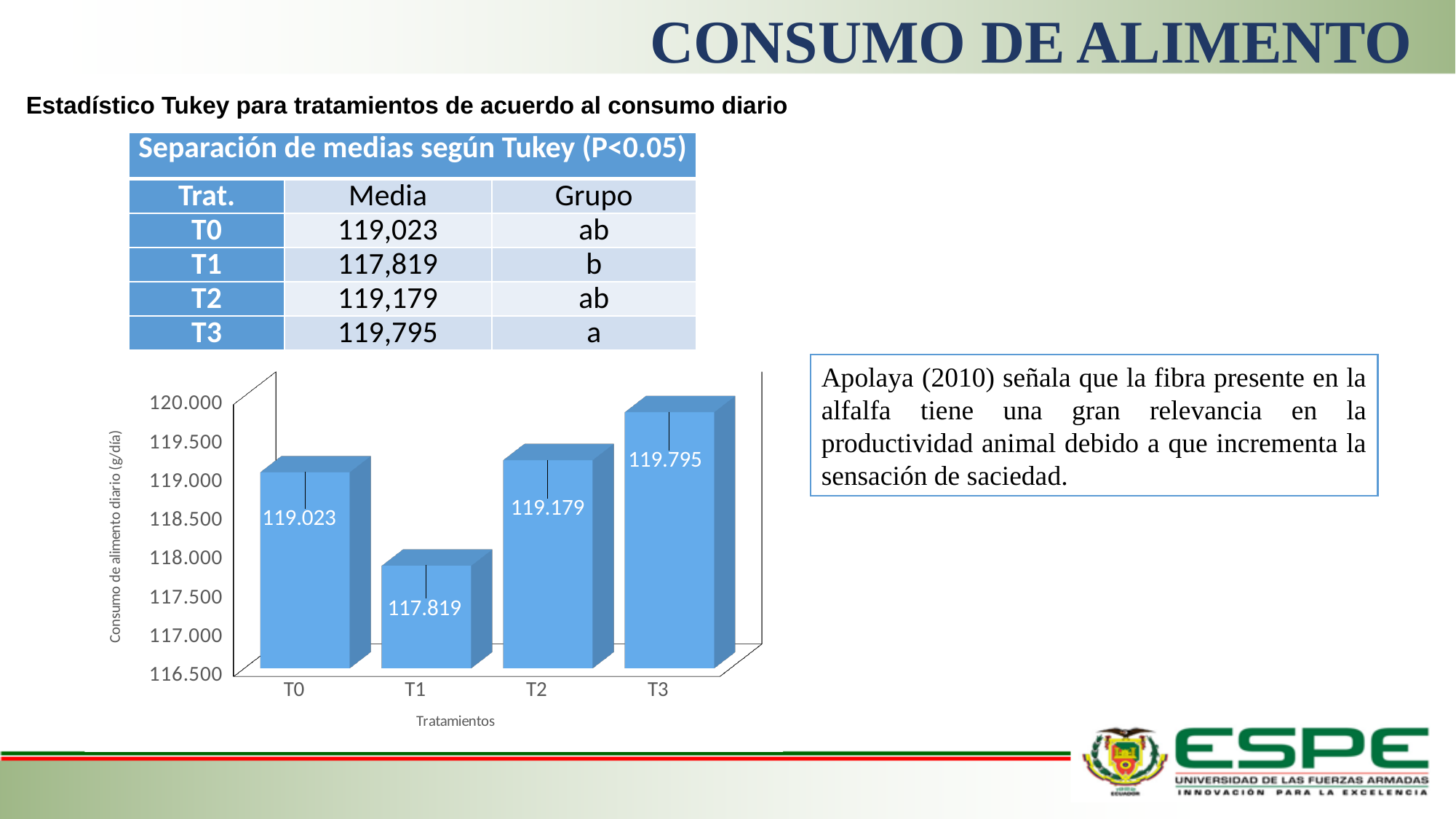
What is the difference between the values for T3 and T1 in the bar chart? 1.976 What is the value shown for T3 in the bar chart? 119.795 What is the value shown for T1 in the bar chart? 117.819 Which treatment has the highest daily feed consumption in the bar chart? T3 How many treatments are plotted on the x axis of the bar chart? 4 What kind of chart is shown on the slide? bar chart What is the value shown for T2 in the bar chart? 119.179 Which treatment has the lowest daily feed consumption in the bar chart? T1 What is the value shown for T0 in the bar chart? 119.023 Is the value for T1 greater or less than 118.000? less What is the label of the vertical axis of the bar chart? Consumo de alimento diario (g/día) Which has a larger value in the bar chart, T0 or T2? T2